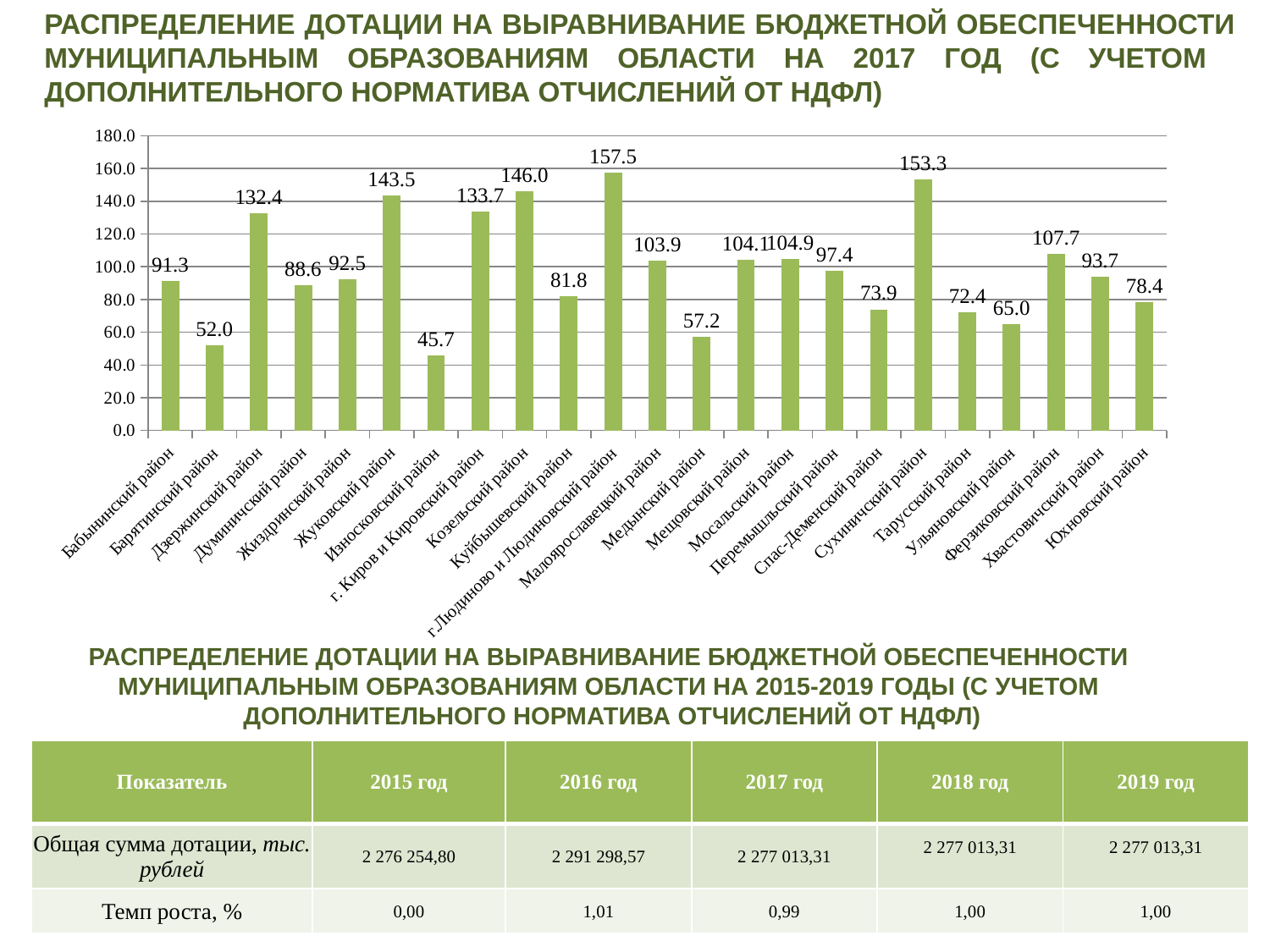
Is the value for Барятинский район greater or less than 60.0? less Which district has the highest value in the chart? г.Людиново и Людиновский район What is the value for Жуковский район? 143.5 What type of chart is shown on the slide? bar chart What is the difference between the values for Козельский район and Куйбышевский район? 64.2 What is the value for Медынский район? 57.2 What is the value for Ферзиковский район? 107.7 What is the difference between the values for Сухиничский район and Тарусский район? 80.9 What is the maximum value shown on the vertical axis of the chart? 180.0 How many districts are shown in the chart? 23 Which district has the lowest value in the chart? Износковский район Which is larger, the value for Дзержинский район or the value for г. Киров и Кировский район? г. Киров и Кировский район